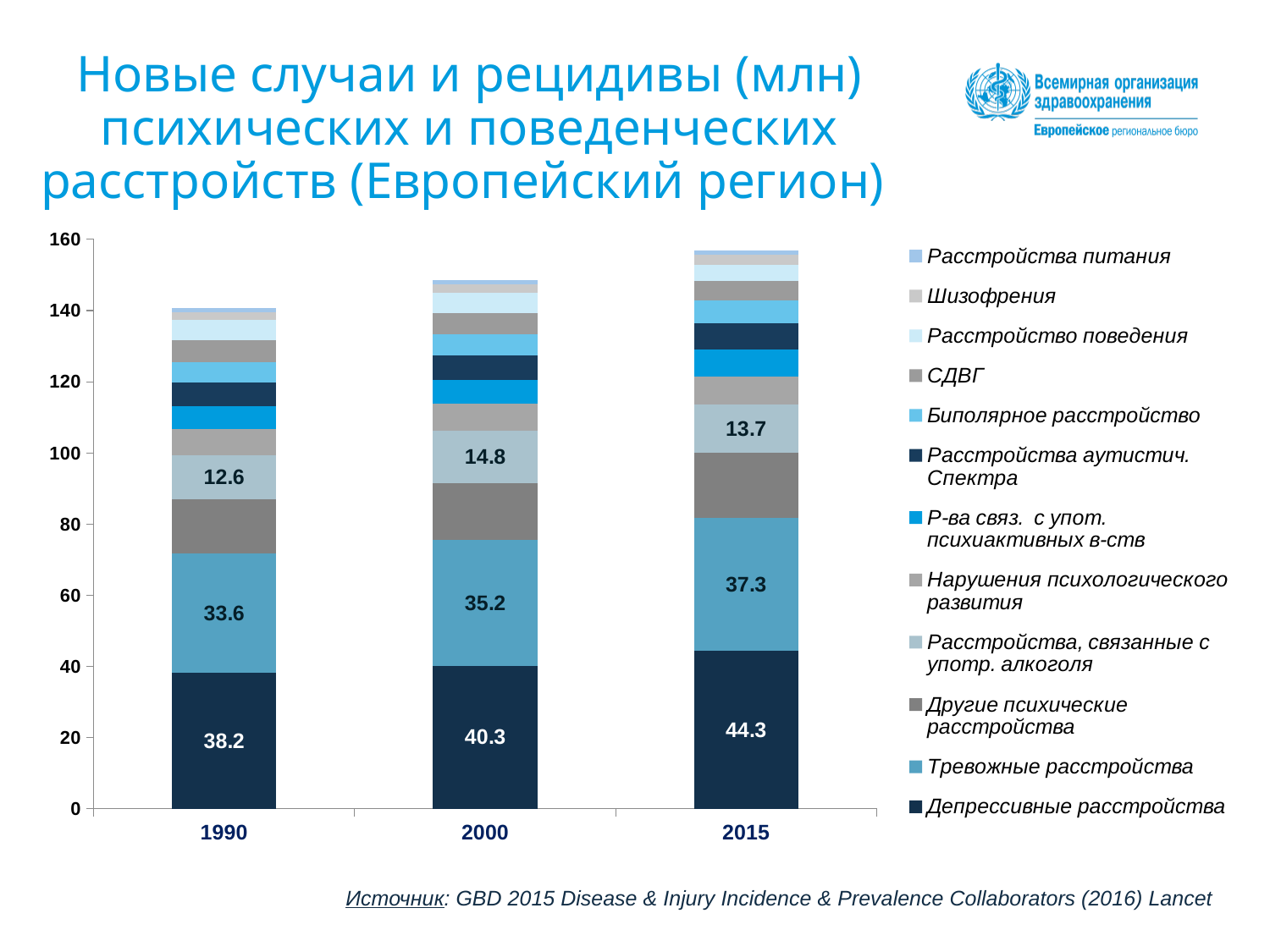
What is the value for Тревожные расстройства in 1990? 33.6 In which year is the value for Депрессивные расстройства highest? 2015 Is the total height of the 2015 stacked bar greater or less than 140? greater What is the value for Депрессивные расстройства in 2015? 44.3 How many years are shown on the x axis? 3 In which year is the value for Расстройства, связанные с употр. алкоголя lowest? 1990 Which is larger: Тревожные расстройства in 2000 or Расстройства, связанные с употр. алкоголя in 2000? Тревожные расстройства in 2000 What kind of chart is shown on the slide? Stacked bar chart What is the value for Расстройства, связанные с употр. алкоголя in 2000? 14.8 Do the values for Тревожные расстройства rise or fall from 1990 to 2015? Rise How many series does the legend list? 12 What is the difference between the Депрессивные расстройства values for 2015 and 1990? 6.1